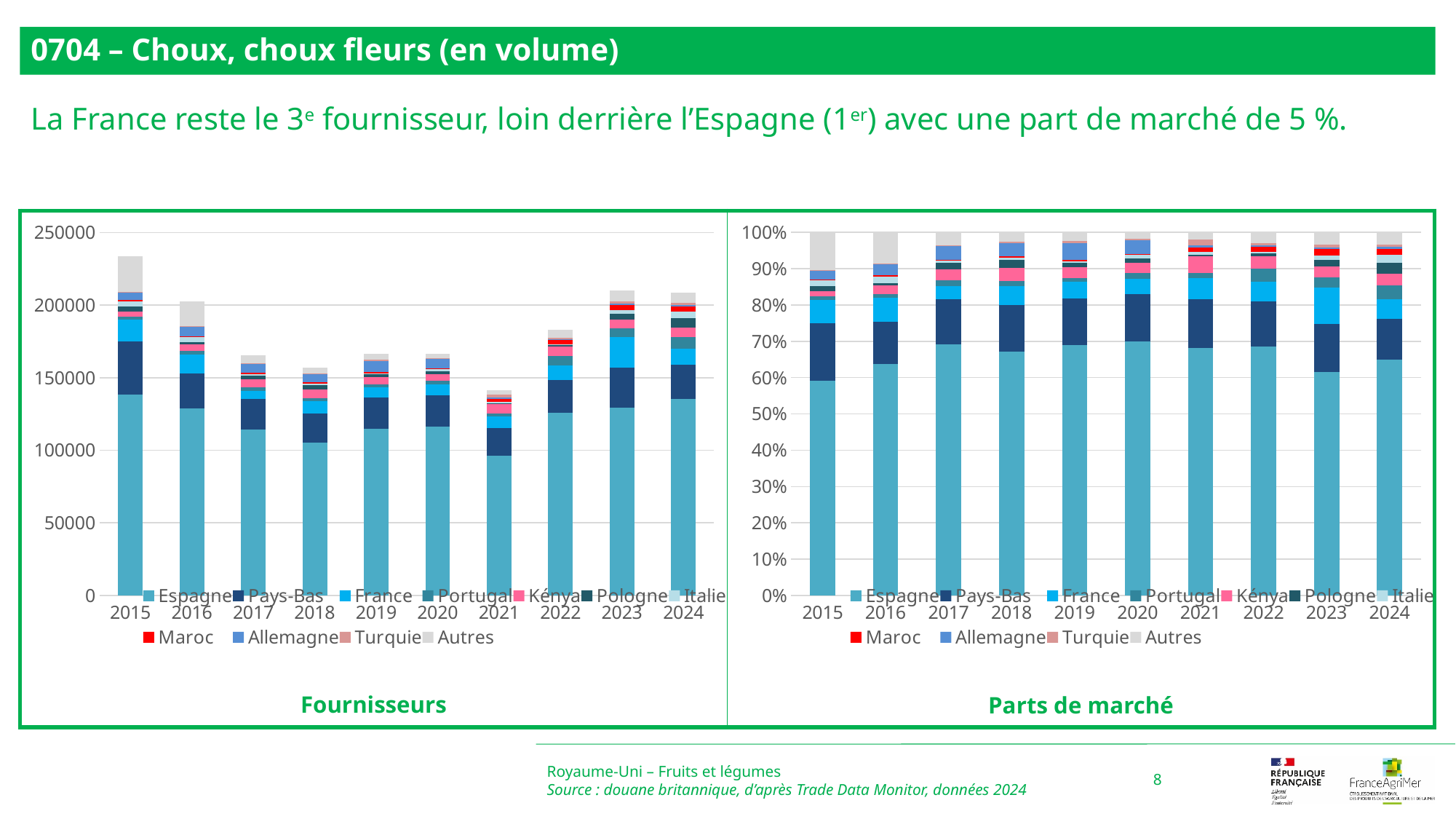
In the 'Parts de marché' chart, is the share of Espagne larger in 2020 or in 2015? 2020 In the 'Fournisseurs' chart, do the total bars rise or fall from 2015 to 2018? fall In the 'Fournisseurs' chart, which year has the lowest total bar? 2021 In the 'Parts de marché' chart, is the share of Espagne in 2020 greater or less than 60%? greater What is the title shown under the right-hand chart? Parts de marché In the 'Fournisseurs' chart, which year has the highest total bar? 2015 How many series does the legend of the 'Parts de marché' chart list? 11 In the 'Fournisseurs' chart, is the total for 2015 greater or less than 200000? greater What kind of chart is the 'Fournisseurs' chart on the left? Stacked bar chart In the 'Fournisseurs' chart, is the total for 2021 greater or less than 150000? less In the 'Fournisseurs' chart, is the total bar for 2023 larger or smaller than the total bar for 2021? larger How many years are shown on the x axis of the 'Fournisseurs' chart? 10